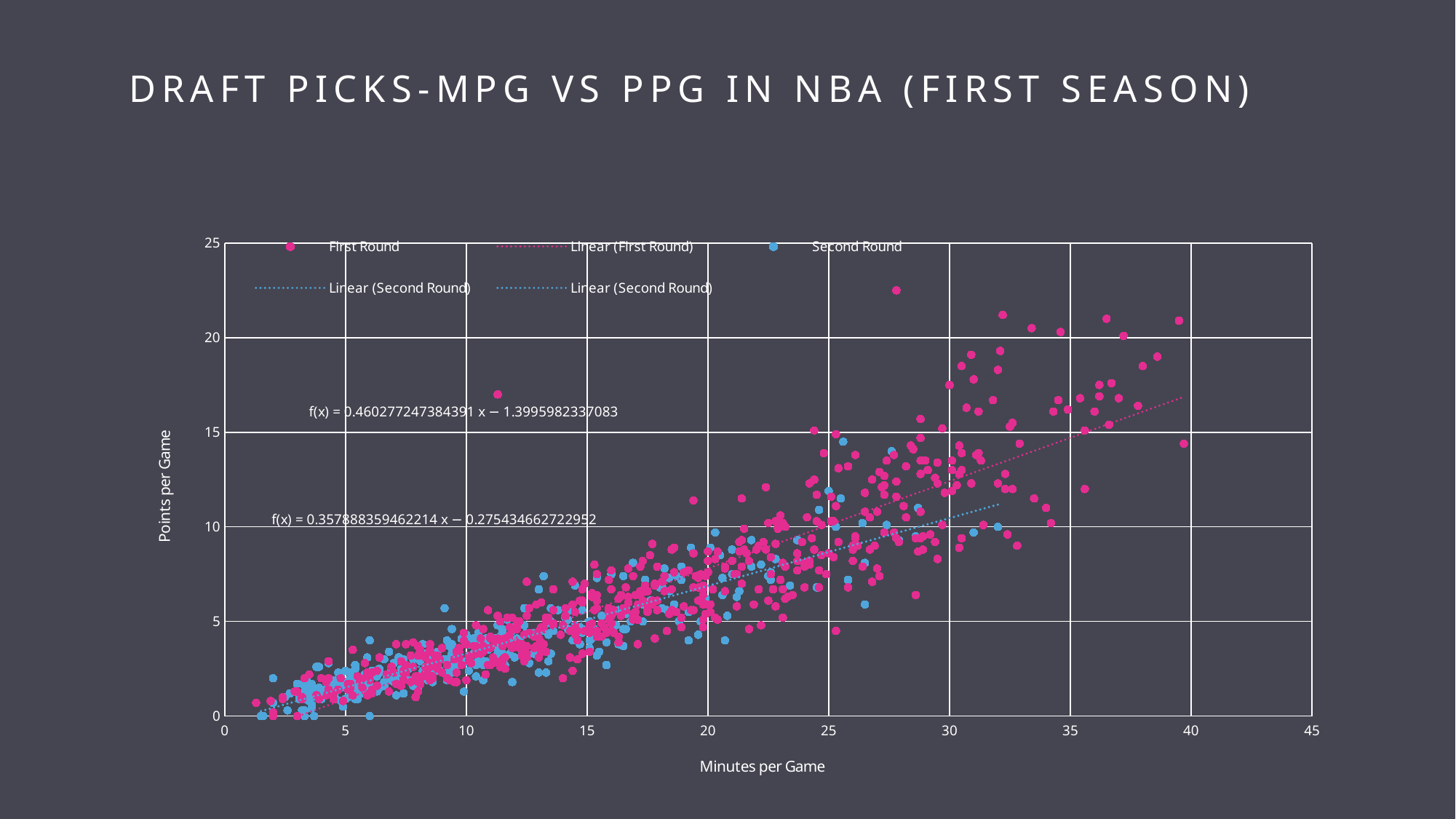
Do points per game generally rise or fall as minutes per game increase? rise What is the highest tick value shown on the Minutes per Game axis? 45 Is the highest Second Round point's points per game value greater or less than 20? less How many entries does the chart's legend list? 5 Is the highest First Round point's points per game value greater or less than 20? greater What is the slope coefficient in the upper trendline equation printed on the chart, f(x) = ... x − 1.3995982337083? 0.460277247384391 Which series has the steeper dotted trendline, First Round or Second Round? First Round What is the intercept in the lower trendline equation printed on the chart, f(x) = 0.357888359462214 x − ...? 0.275434662722952 What kind of chart is shown on the slide? scatter chart What colour are the Second Round points plotted in? blue What is the title of the chart? DRAFT PICKS-MPG VS PPG IN NBA (FIRST SEASON) What is the highest tick value shown on the Points per Game axis? 25